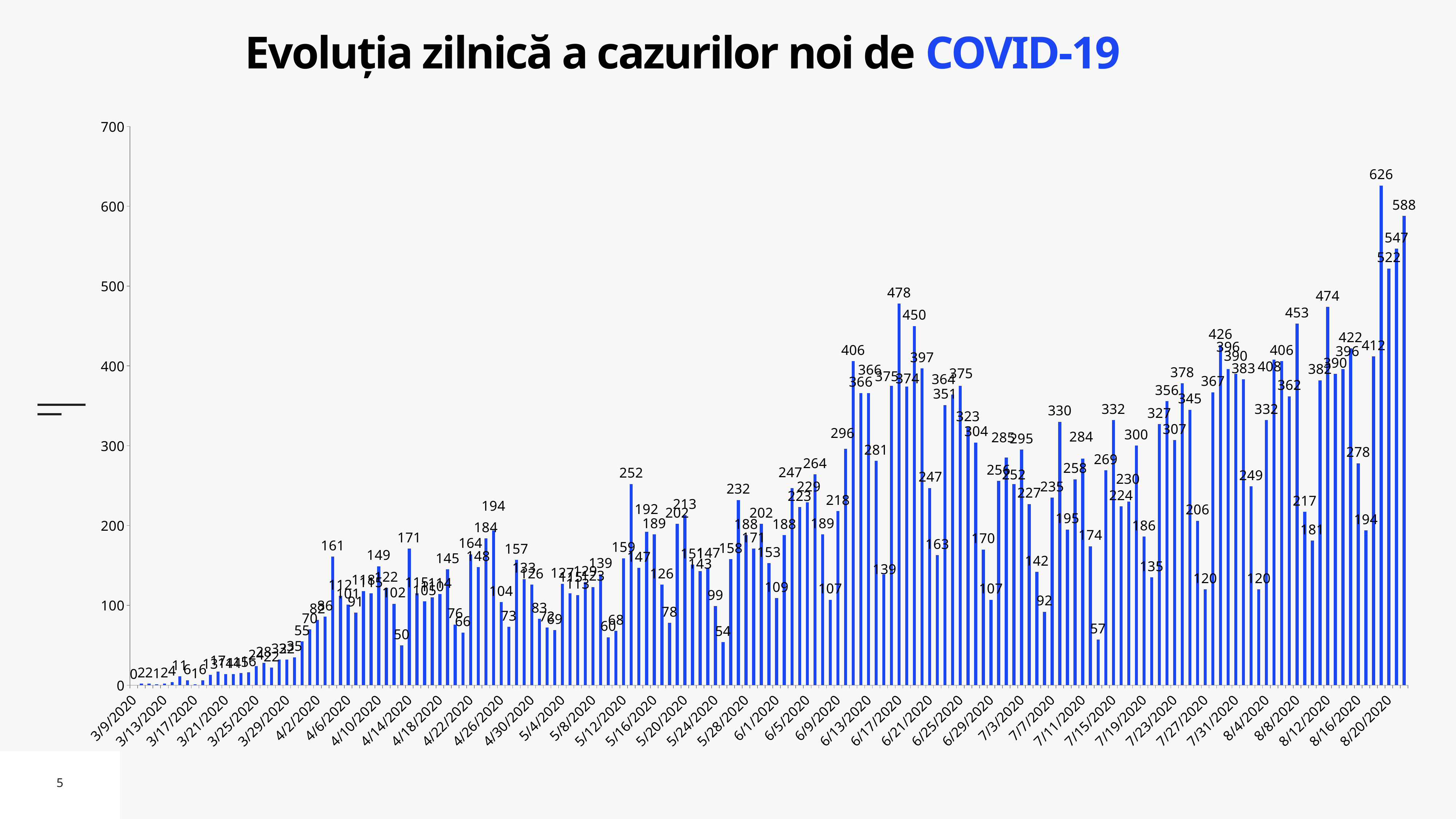
What is the highest daily value shown on the chart? 626 What is the title of the chart? Evoluția zilnică a cazurilor noi de COVID-19 Overall, do the daily values rise or fall from March to August along the x axis? rise What is the difference between the tallest bar (626) and the last bar (588)? 38 Is the value of the last bar on the chart greater or less than 500? greater What is the maximum value shown on the vertical axis? 700 What kind of chart is shown on the slide? bar chart What is the highest value reached in the mid-June peak of the chart? 478 What is the value of the bar immediately before the tallest bar? 412 Which is larger, the bar labelled 626 or the bar labelled 588? 626 What is the value of the last (rightmost) bar on the chart? 588 How many data series are plotted on the chart? 1